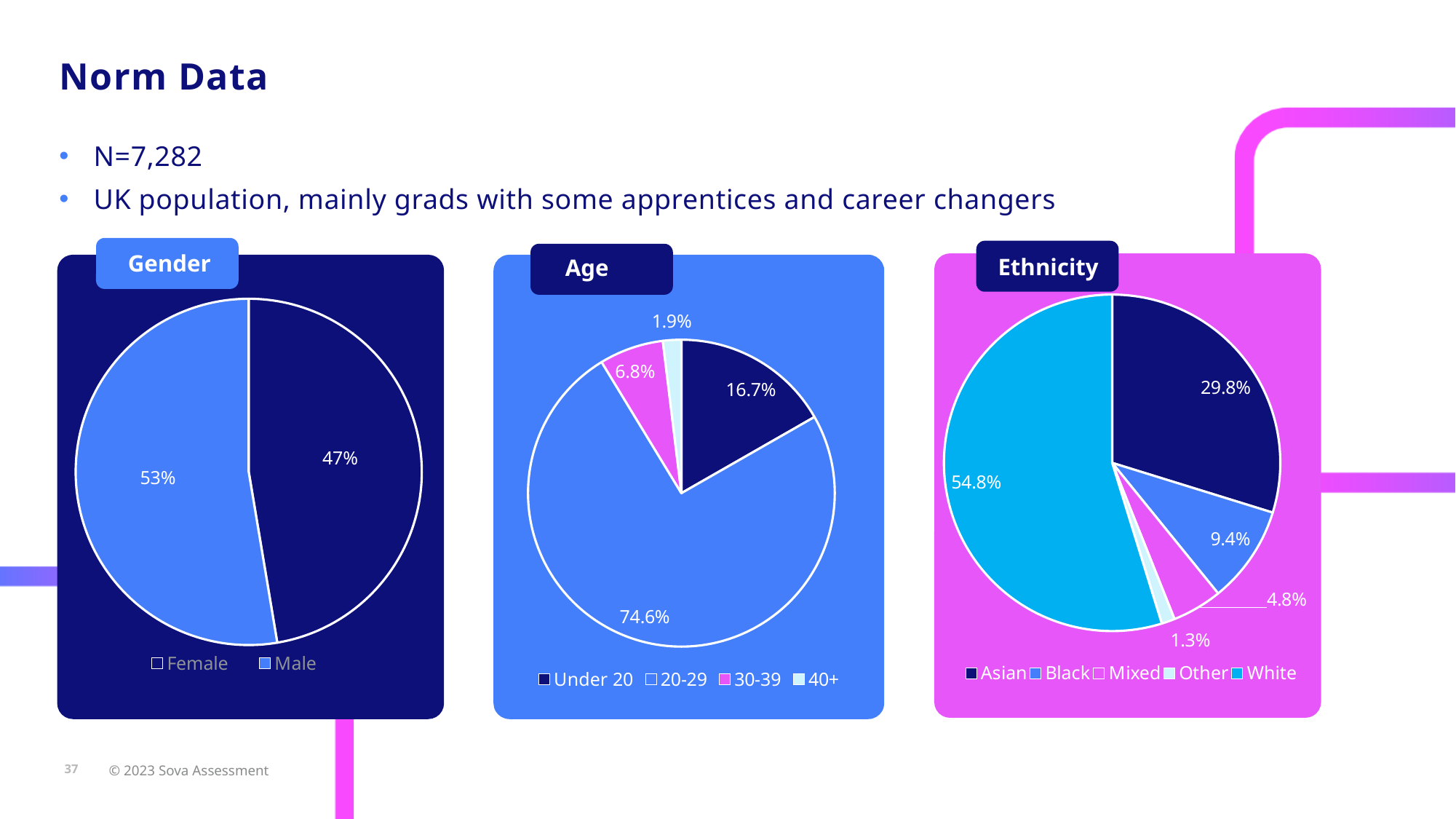
In the Ethnicity chart, what share is Black? 9.4% In the Ethnicity chart, what share is White? 54.8% In the Gender chart, what is the difference between the two slices? 6 percentage points In the Ethnicity chart, which category has the largest share? White In the Age chart, what is the difference between the 30-39 share and the 40+ share? 4.9 percentage points In the Ethnicity chart, which is larger, Asian or Mixed? Asian In the Age chart, what share is the Under 20 group? 16.7% How many categories does the Ethnicity chart's legend list? 5 In the Age chart, which age group has the smallest share? 40+ In the Age chart, what share is the 20-29 group? 74.6% How many slices does the Gender chart have? 2 What kind of charts are shown on the slide? Pie charts